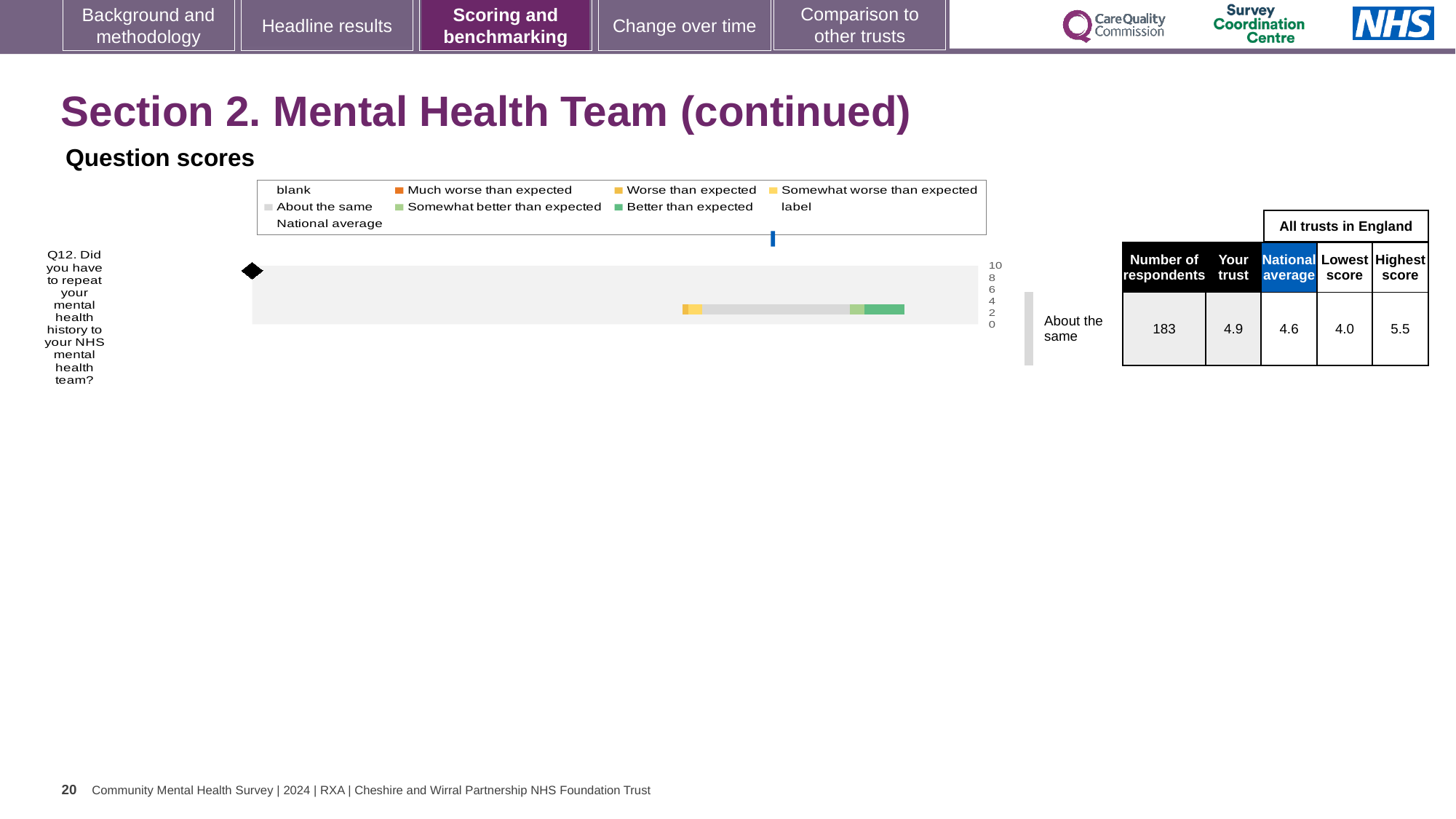
What benchmark category is shown for Q12 next to the chart? About the same What is the difference between the highest and lowest scores for Q12 across all trusts in England? 1.5 What kind of chart is used to show the Q12 benchmarking result? bar chart What is the lowest score among all trusts in England for Q12? 4.0 What is the highest score among all trusts in England for Q12? 5.5 What is the difference between the 'Your trust' score and the national average for Q12? 0.3 What is the 'Your trust' score for Q12? 4.9 How many respondents are shown for Q12? 183 Which survey question does the chart on this slide relate to? Q12. Did you have to repeat your mental health history to your NHS mental health team? What is the national average score for Q12? 4.6 Which is larger for Q12, the 'Your trust' score or the national average? Your trust What colour represents 'Better than expected' in the chart legend? green